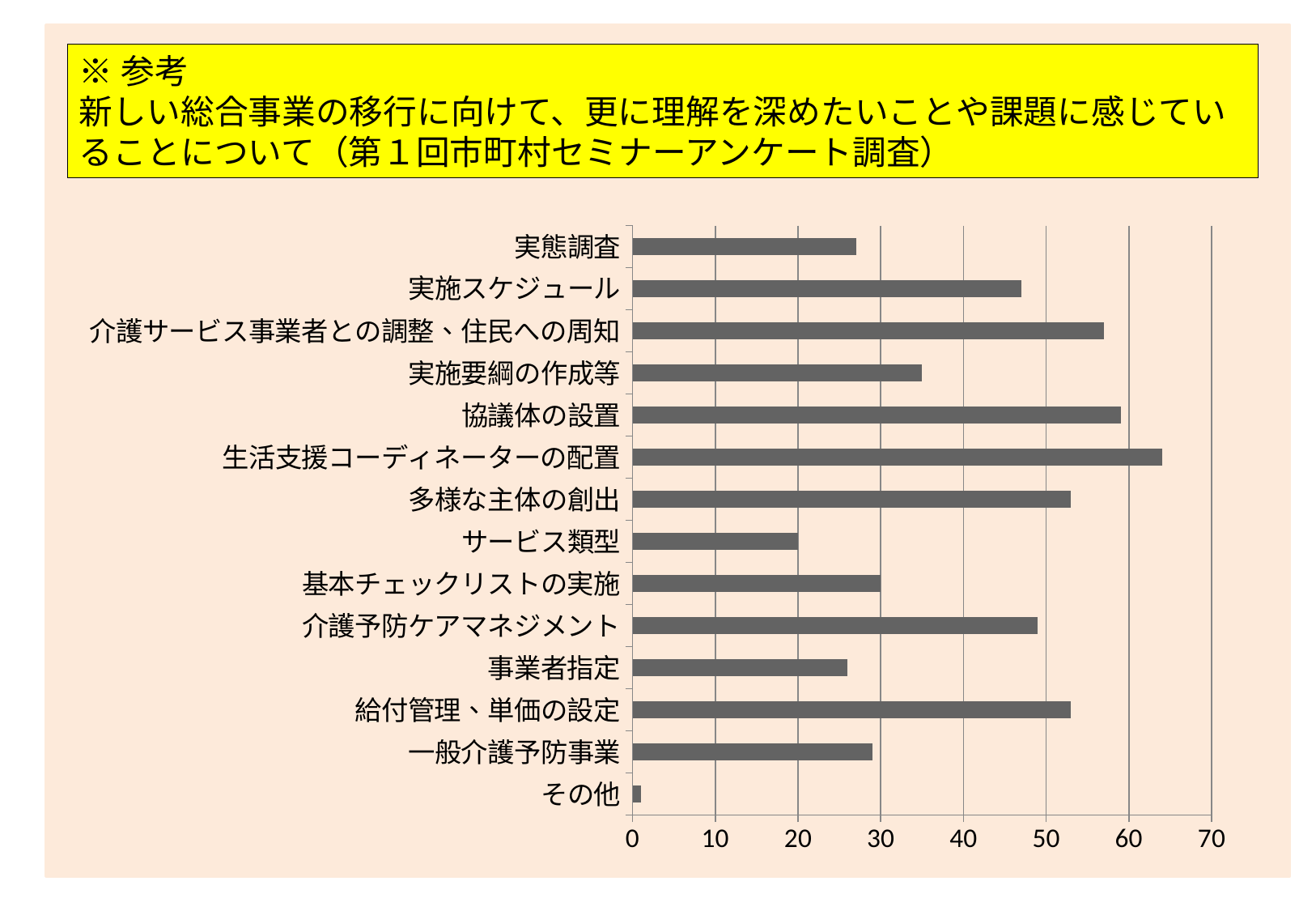
Is the value for 実施要綱の作成等 greater or less than 40? less What kind of chart is shown on the slide? bar chart Is the value for 実施スケジュール greater or less than 40? greater Which has the larger value, 協議体の設置 or 実施要綱の作成等? 協議体の設置 Is the value for 事業者指定 greater or less than 30? less Which category has the lowest value in the chart? その他 How many categories are plotted in the chart? 14 Which category has the highest value in the chart? 生活支援コーディネーターの配置